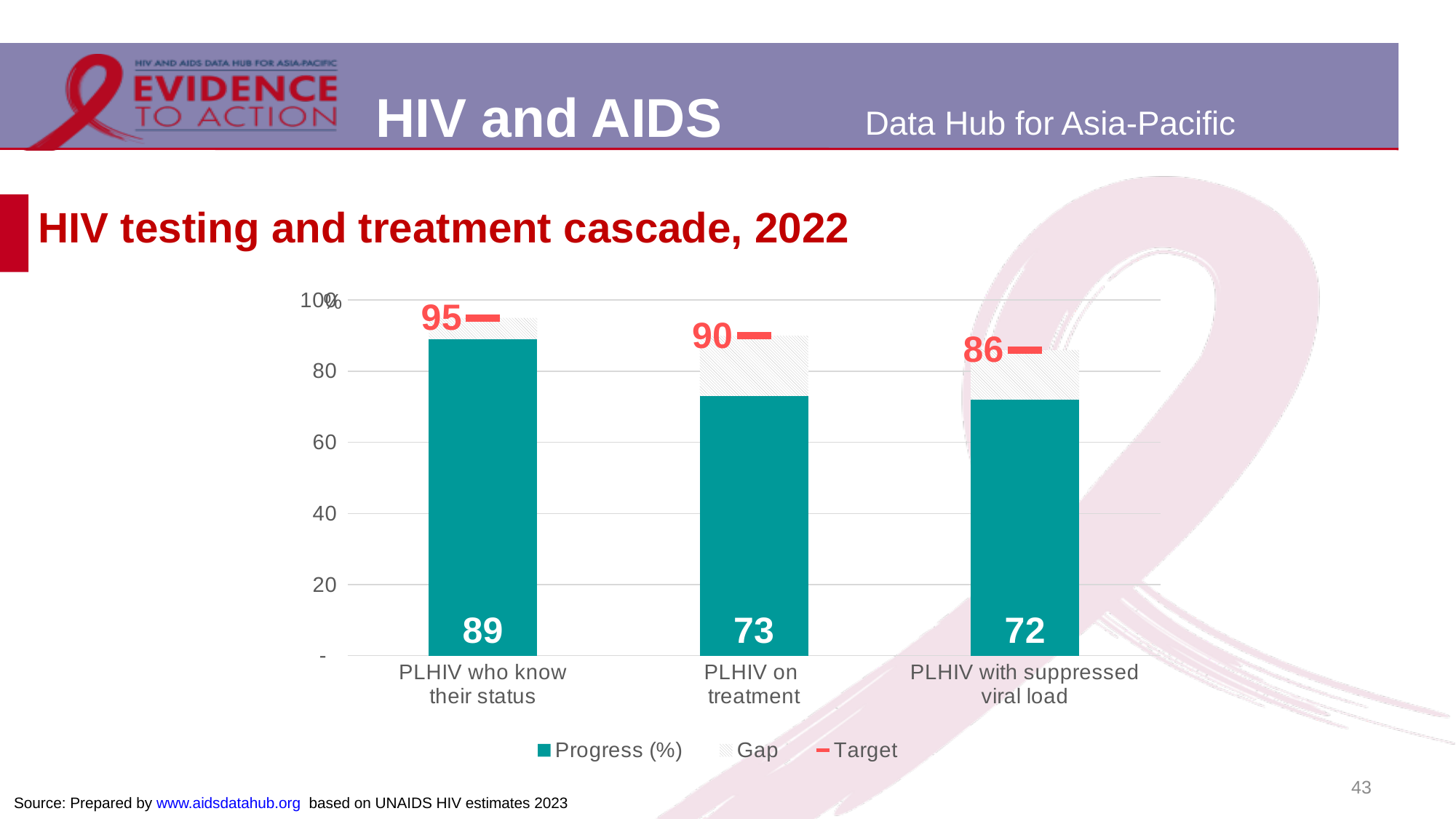
What is the difference between the Target and the Progress (%) for PLHIV on treatment? 17 How many series does the legend list? 3 What is the Progress (%) value for PLHIV on treatment? 73 Which is larger: the Progress (%) for PLHIV on treatment or for PLHIV with suppressed viral load? PLHIV on treatment Which category has the lowest Target value? PLHIV with suppressed viral load What is the Target value for PLHIV with suppressed viral load? 86 What is the Target value for PLHIV on treatment? 90 What kind of chart is shown on the slide? Bar chart What is the Progress (%) value for PLHIV who know their status? 89 Which category has the highest Progress (%) value? PLHIV who know their status What is the difference in Progress (%) between PLHIV who know their status and PLHIV with suppressed viral load? 17 How many categories are shown on the x axis? 3